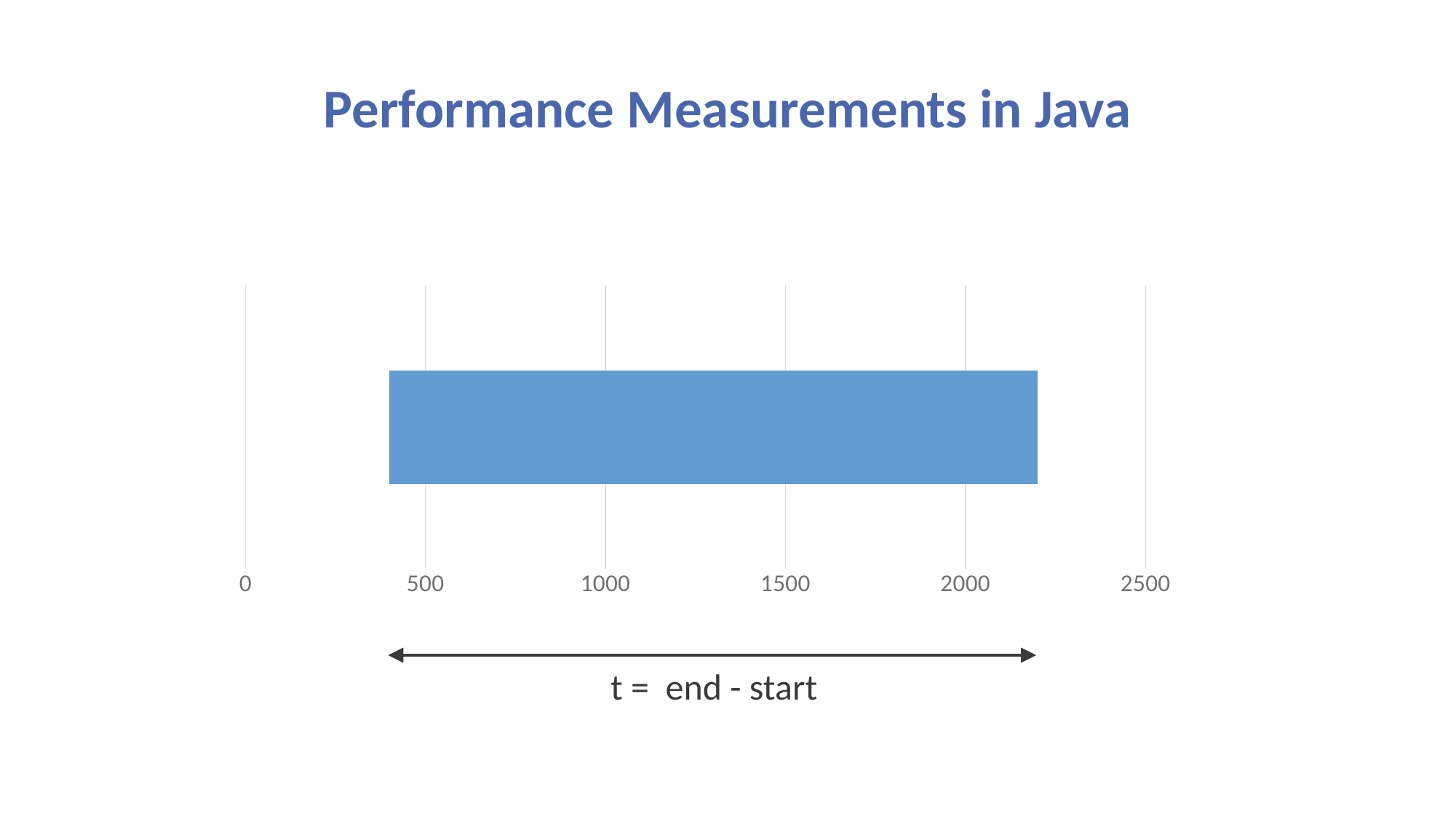
What is the largest tick value shown on the horizontal axis? 2500 Is the right end of the bar greater or less than 2500? less What is the title of the slide? Performance Measurements in Java Is the right end of the bar greater or less than 2000? greater Does the bar start at 0 on the axis? No How many bars are plotted in the chart? 1 What kind of chart is shown on the slide? bar chart